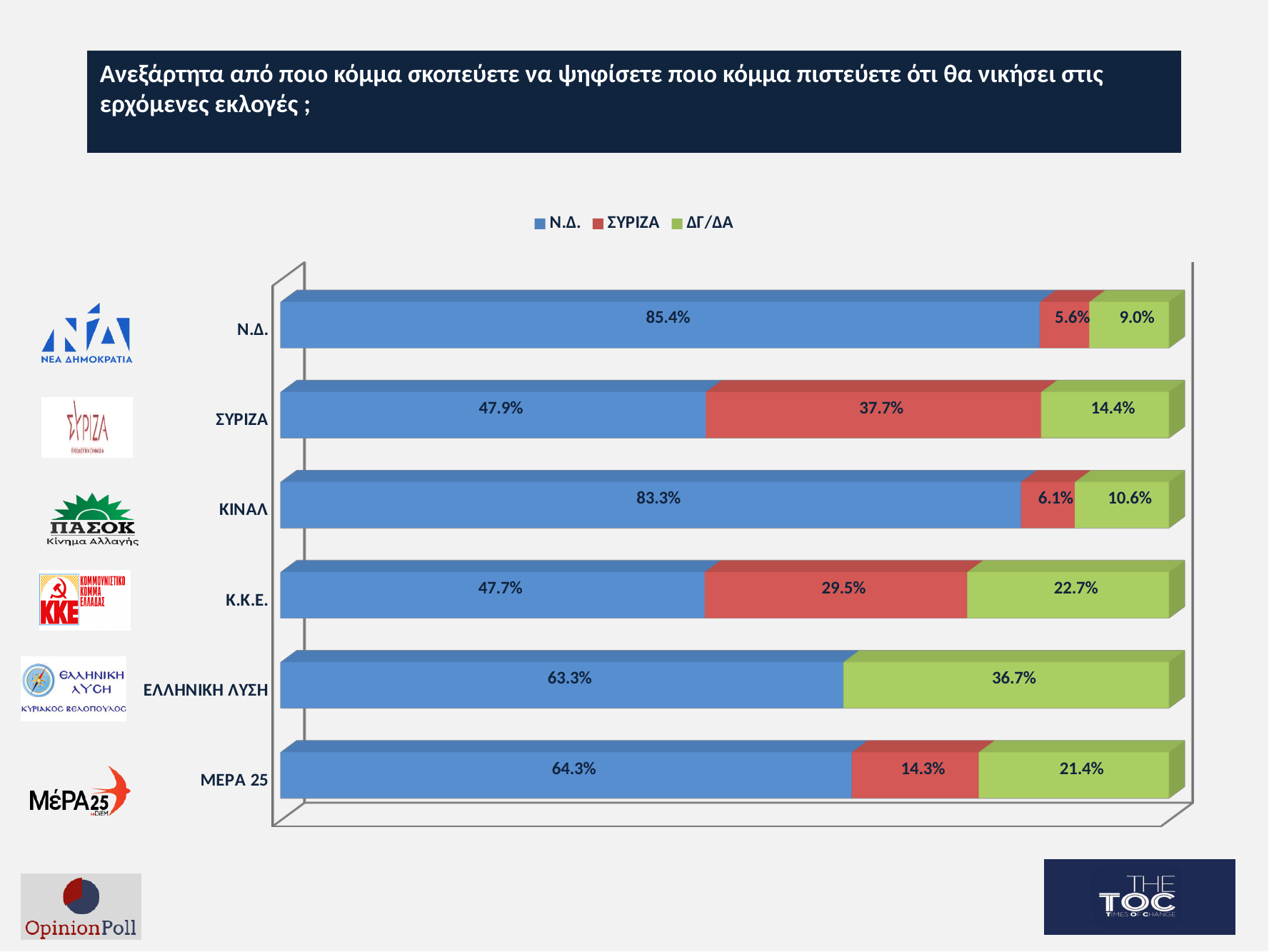
What is the difference between the Ν.Δ. value for ΚΙΝΑΛ and the Ν.Δ. value for ΜΕΡΑ 25? 19.0% How many series does the legend list? 3 Which series is shown in green in the legend? ΔΓ/ΔΑ Which is larger: the ΣΥΡΙΖΑ value for ΣΥΡΙΖΑ or the ΣΥΡΙΖΑ value for ΜΕΡΑ 25? ΣΥΡΙΖΑ What is the ΣΥΡΙΖΑ value for the Κ.Κ.Ε. category? 29.5% What is the Ν.Δ. value for the ΣΥΡΙΖΑ voters category? 47.9% How many party categories are shown on the chart? 6 Which category has the highest Ν.Δ. value? Ν.Δ. What is the ΔΓ/ΔΑ value for the ΕΛΛΗΝΙΚΗ ΛΥΣΗ category? 36.7% Which category has the lowest ΔΓ/ΔΑ value? Ν.Δ. What kind of chart is shown on the slide? Stacked bar chart Which category has the highest ΣΥΡΙΖΑ value? ΣΥΡΙΖΑ